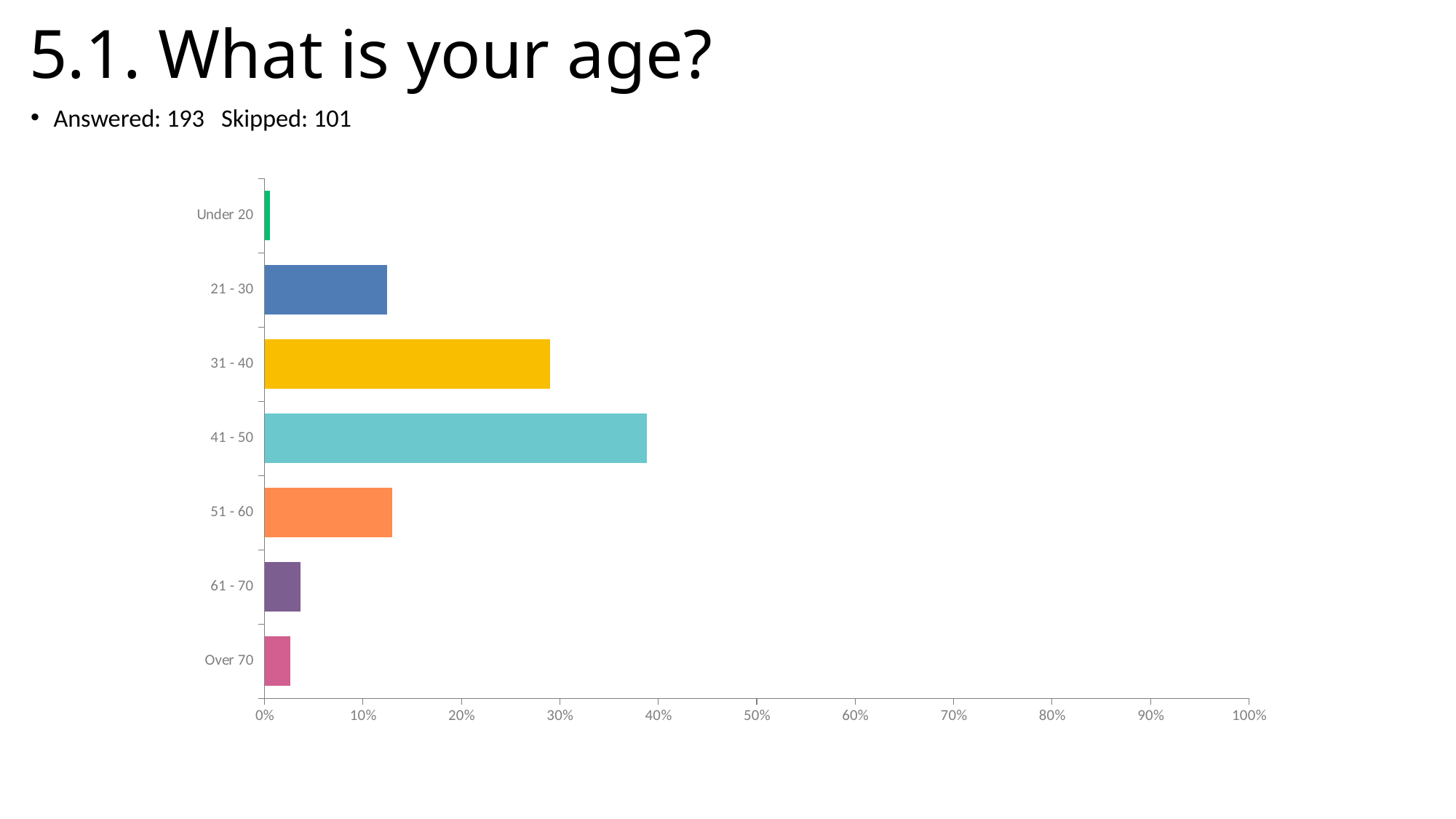
Is the value for 21 - 30 greater or less than 20%? less How many age categories are plotted in the chart? 7 Which is larger, the value for 31 - 40 or the value for 51 - 60? 31 - 40 Is the value for 41 - 50 greater or less than 50%? less Is the value for 61 - 70 greater or less than 10%? less Which age category has the lowest value? Under 20 Which is larger, the value for 41 - 50 or the value for 21 - 30? 41 - 50 What kind of chart is shown on the slide? bar chart What is the highest tick label shown on the horizontal axis? 100% Which age category has the highest value? 41 - 50